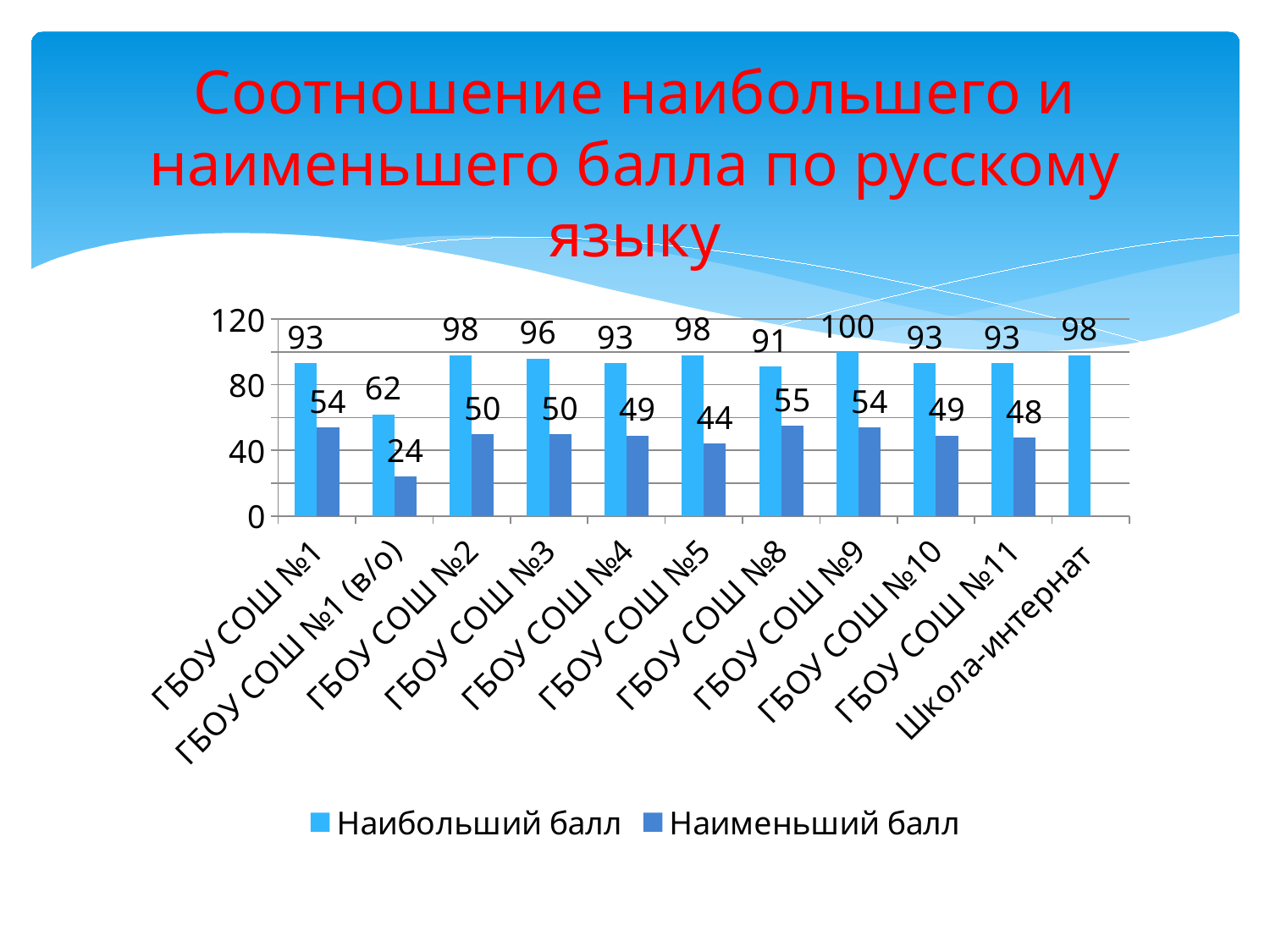
What is the Наименьший балл value for ГБОУ СОШ №5? 44 What is the Наименьший балл value for ГБОУ СОШ №1 (в/о)? 24 What is the Наибольший балл value for ГБОУ СОШ №9? 100 How many schools are shown on the x axis? 11 Which is larger: the Наименьший балл for ГБОУ СОШ №8 or for ГБОУ СОШ №11? ГБОУ СОШ №8 Which school has the highest Наибольший балл? ГБОУ СОШ №9 What kind of chart is shown on the slide? bar chart Is the Наибольший балл for ГБОУ СОШ №1 (в/о) greater or less than 80? less Which school has the lowest Наименьший балл? ГБОУ СОШ №1 (в/о) How many series does the legend list? 2 Which school has the lowest Наибольший балл? ГБОУ СОШ №1 (в/о) What is the difference between the Наибольший балл and Наименьший балл for ГБОУ СОШ №8? 36